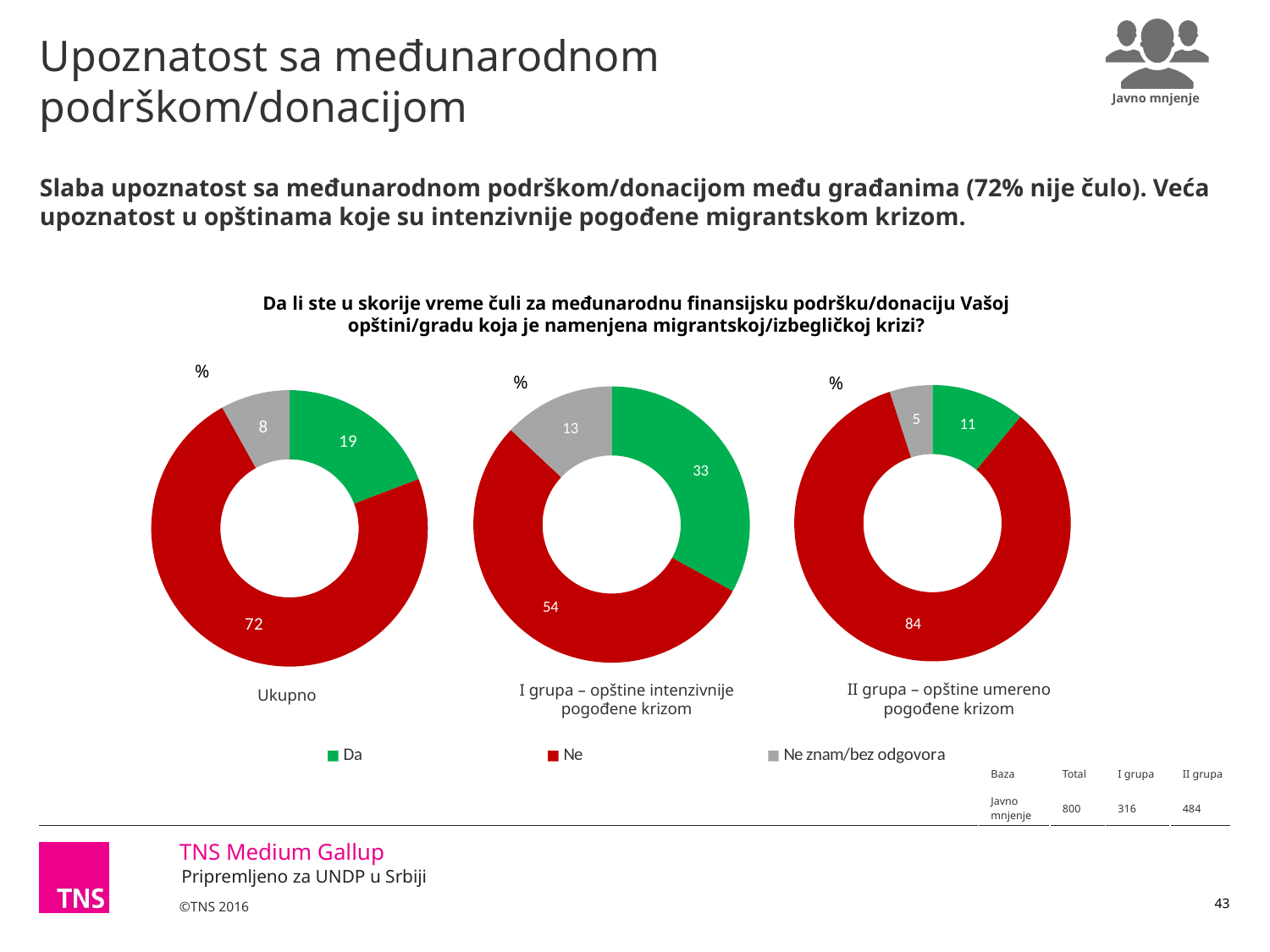
In the 'Ukupno' chart, what is the difference between the 'Ne' and 'Da' values? 53 Which colour represents 'Ne' in the charts? Red What kind of chart is used on this slide? Donut (pie) chart In the 'I grupa – opštine intenzivnije pogođene krizom' chart, which category has the smallest share? Ne znam/bez odgovora Which is larger: the 'Da' value in the 'I grupa' chart or the 'Da' value in the 'II grupa' chart? I grupa In the 'Ukupno' chart, which category has the largest share? Ne In the 'II grupa – opštine umereno pogođene krizom' chart, what is the value for 'Ne znam/bez odgovora'? 5 How many series does the legend list? 3 In the 'I grupa – opštine intenzivnije pogođene krizom' chart, what is the value for 'Da'? 33 In the 'Ukupno' chart, what is the value for 'Ne'? 72 What is the difference between the 'Ne' value in the 'II grupa' chart and the 'Ne' value in the 'I grupa' chart? 30 How many donut charts are shown on the slide? 3